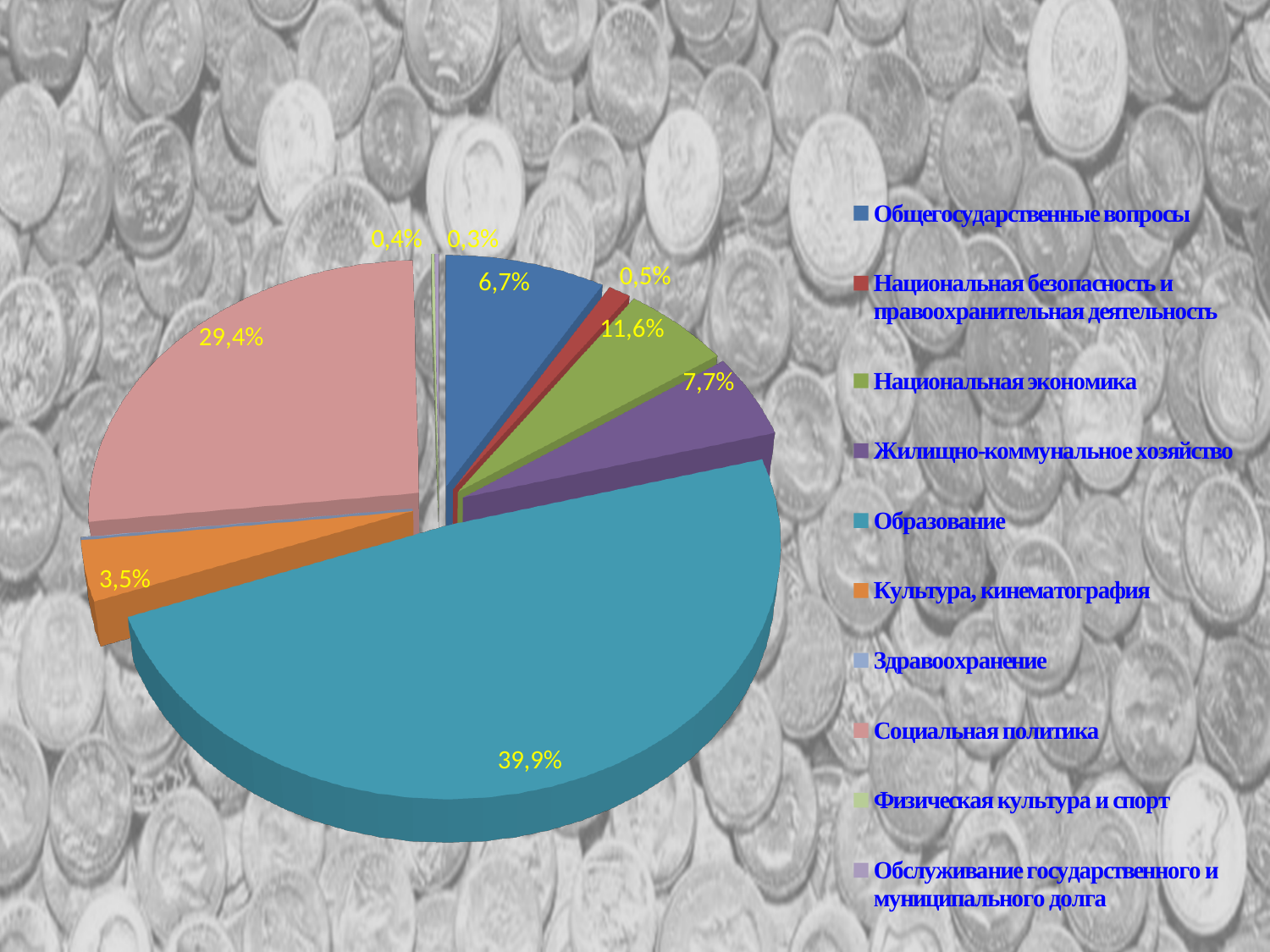
What share of the pie does Социальная политика have? 29,4% What share of the pie does Национальная экономика have? 11,6% What share of the pie does Общегосударственные вопросы have? 6,7% What kind of chart is shown on the slide? pie chart What colour is the slice for Образование? teal (blue-green) What is the difference in percentage points between Образование and Социальная политика? 10,5 What share of the pie does Культура, кинематография have? 3,5% What share of the pie does Жилищно-коммунальное хозяйство have? 7,7% How many categories does the legend list? 10 Which category has the largest share of the pie? Образование What share of the pie does Образование have? 39,9% Which is larger, the share for Национальная экономика or the share for Жилищно-коммунальное хозяйство? Национальная экономика